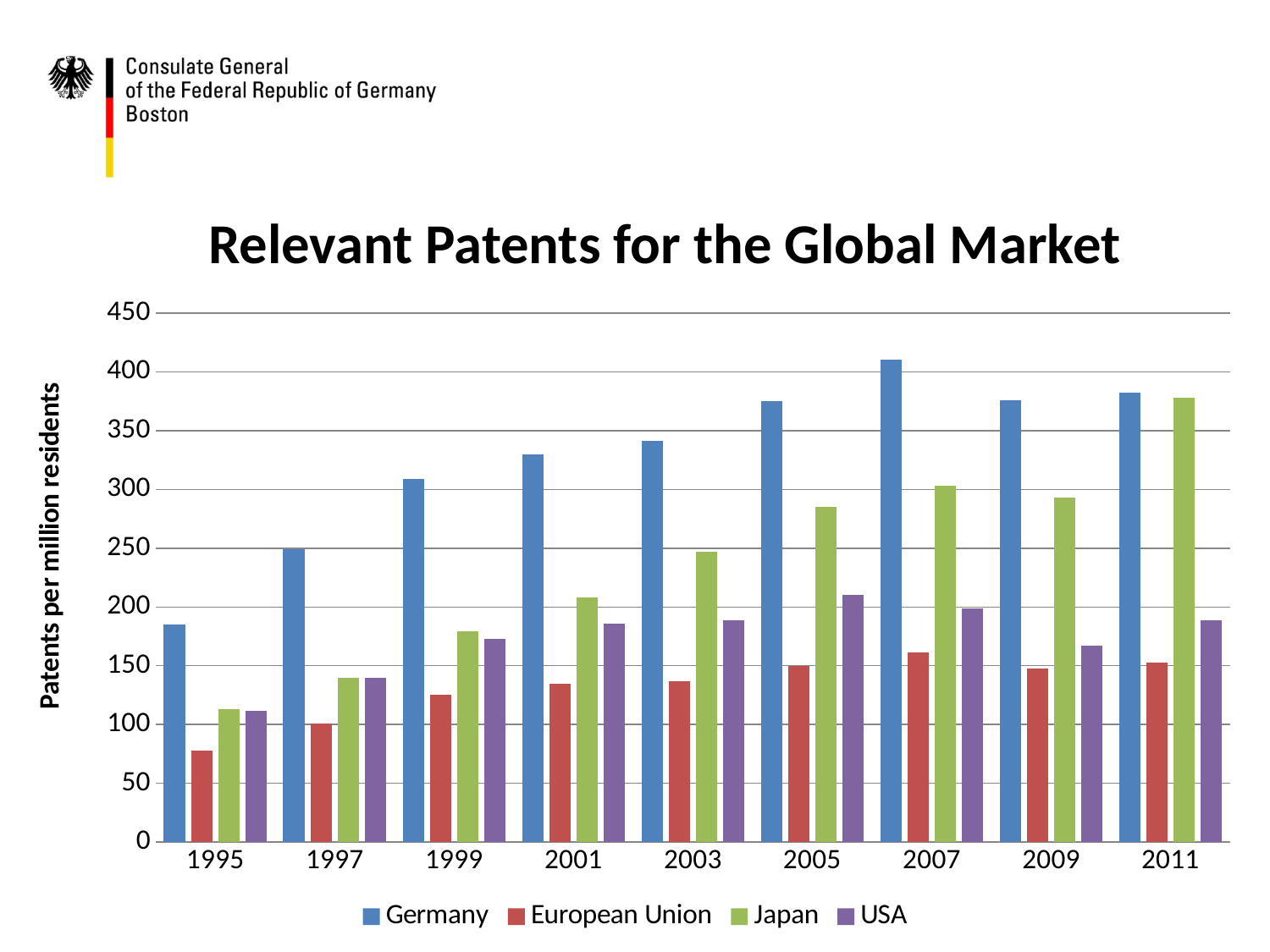
Is the value for Japan in 2011 greater or less than 350? greater In which year is the value for the European Union lowest? 1995 How many series does the legend list? 4 Do the values for Germany rise or fall from 1995 to 2007? rise In 2011, which is larger: the value for Japan or the value for the USA? Japan What is the title of the y axis? Patents per million residents What kind of chart is shown on the slide? bar chart In 1995, which is larger: the value for Germany or the value for Japan? Germany Is the value for Germany in 2007 greater or less than 400? greater How many years are shown on the x axis? 9 Is the value for the European Union in 1995 greater or less than 100? less In which year is the value for Germany highest? 2007